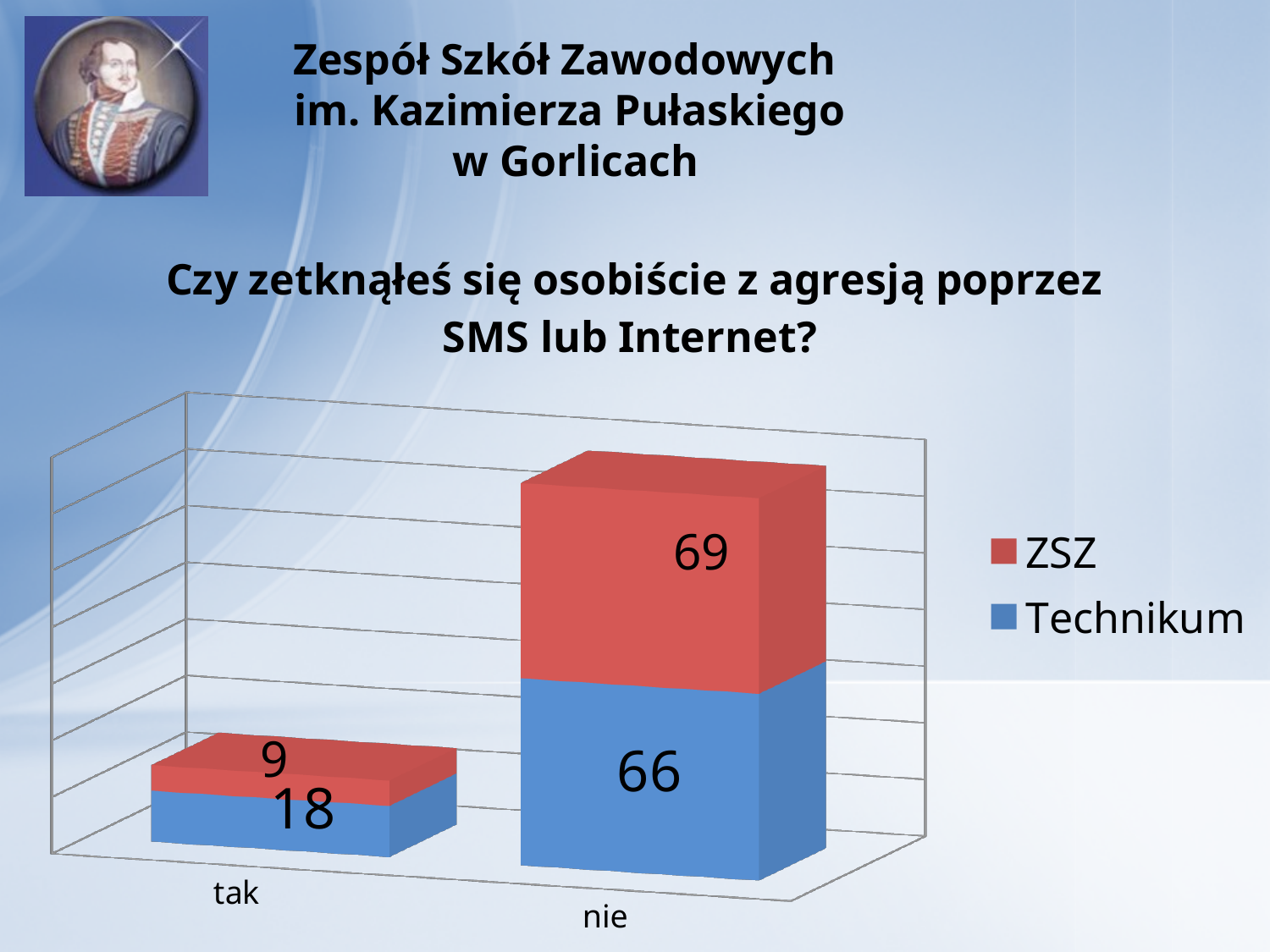
What is the difference between the Technikum and ZSZ values in the "tak" category? 9 What kind of chart is shown on the slide? Stacked bar chart What is the value for Technikum in the "tak" category? 18 What is the total of the stacked bar for "nie"? 135 Which category has the higher total, "tak" or "nie"? nie How many categories are shown on the x axis? 2 How many series does the legend list? 2 What is the value for ZSZ in the "nie" category? 69 What is the value for ZSZ in the "tak" category? 9 What is the value for Technikum in the "nie" category? 66 What is the difference between the ZSZ values for "nie" and "tak"? 60 What is the total of the stacked bar for "tak"? 27